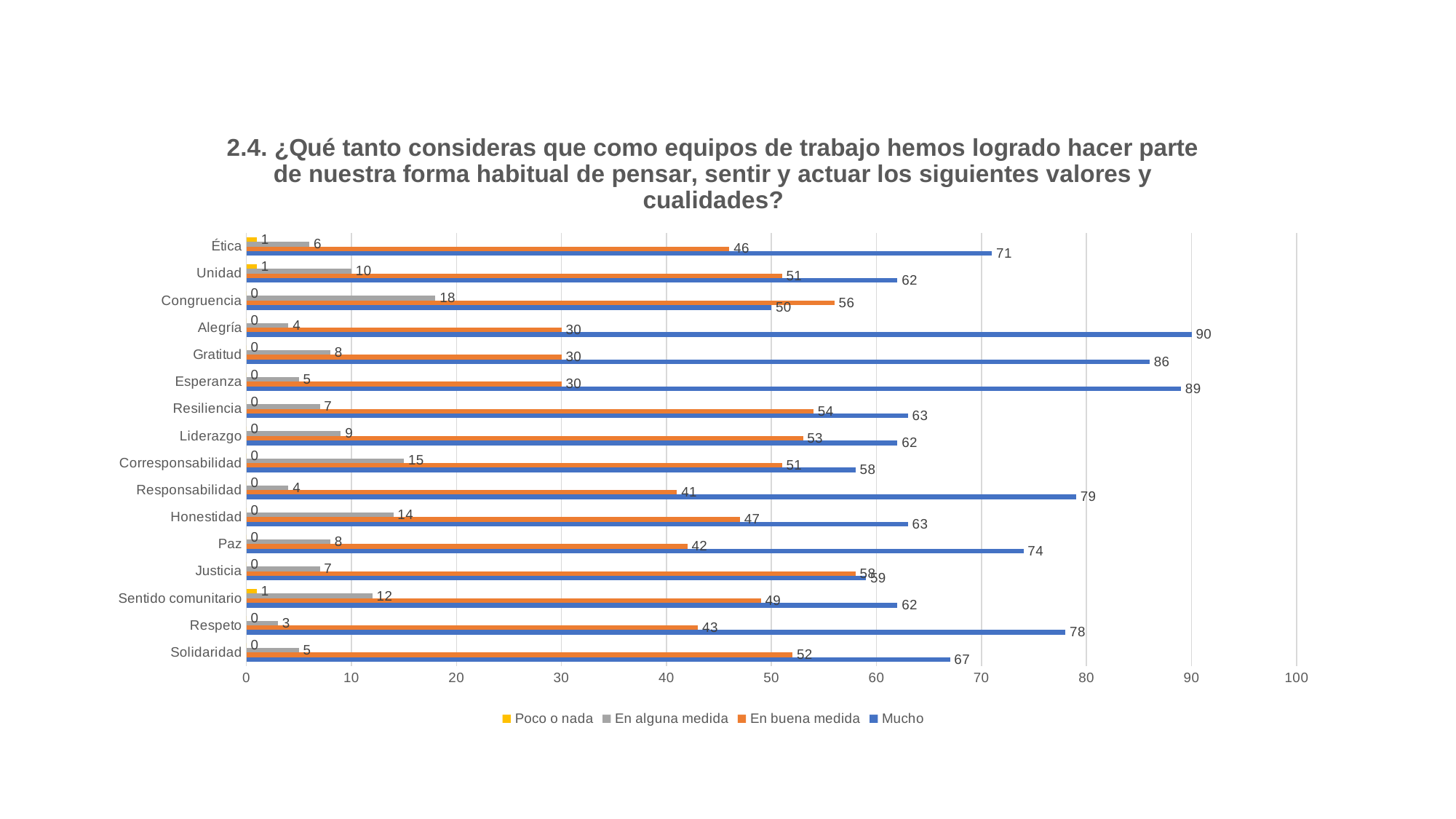
Which is larger: the 'Mucho' value for Responsabilidad or for Paz? Responsabilidad How many categories are shown on the chart? 16 Which colour represents the 'Poco o nada' series? yellow What is the difference between the 'Mucho' values for Respeto and Solidaridad? 11 What is the value for 'En buena medida' for Congruencia? 56 Is the 'Mucho' value for Gratitud greater or less than 80? greater What kind of chart is this? bar chart What is the value for 'Mucho' for Alegría? 90 How many series does the legend list? 4 What is the value for 'En alguna medida' for Corresponsabilidad? 15 Which category has the lowest 'En buena medida' value? Alegría, Gratitud and Esperanza (all 30) Which category has the highest 'Mucho' value? Alegría